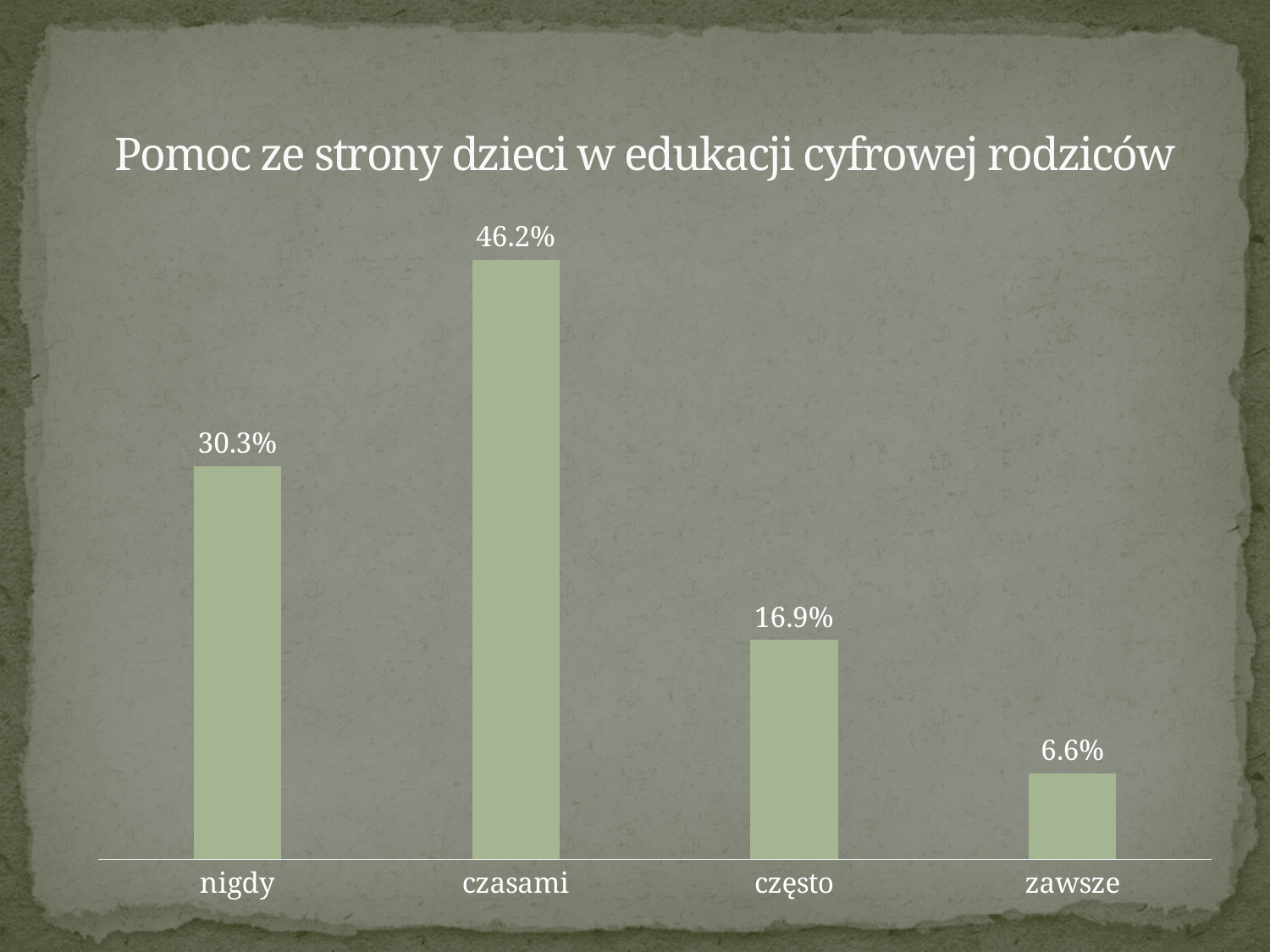
Which category has the highest value? czasami What kind of chart is shown on the slide? bar chart What is the value for "nigdy"? 30.3% What is the difference between the values for "często" and "zawsze"? 10.3% What is the value for "często"? 16.9% What is the difference between the values for "czasami" and "nigdy"? 15.9% Which is larger, the value for "nigdy" or the value for "często"? nigdy Which category has the lowest value? zawsze What is the value for "czasami"? 46.2% What is the value for "zawsze"? 6.6% How many categories are shown on the x axis? 4 What is the title of the chart? Pomoc ze strony dzieci w edukacji cyfrowej rodziców